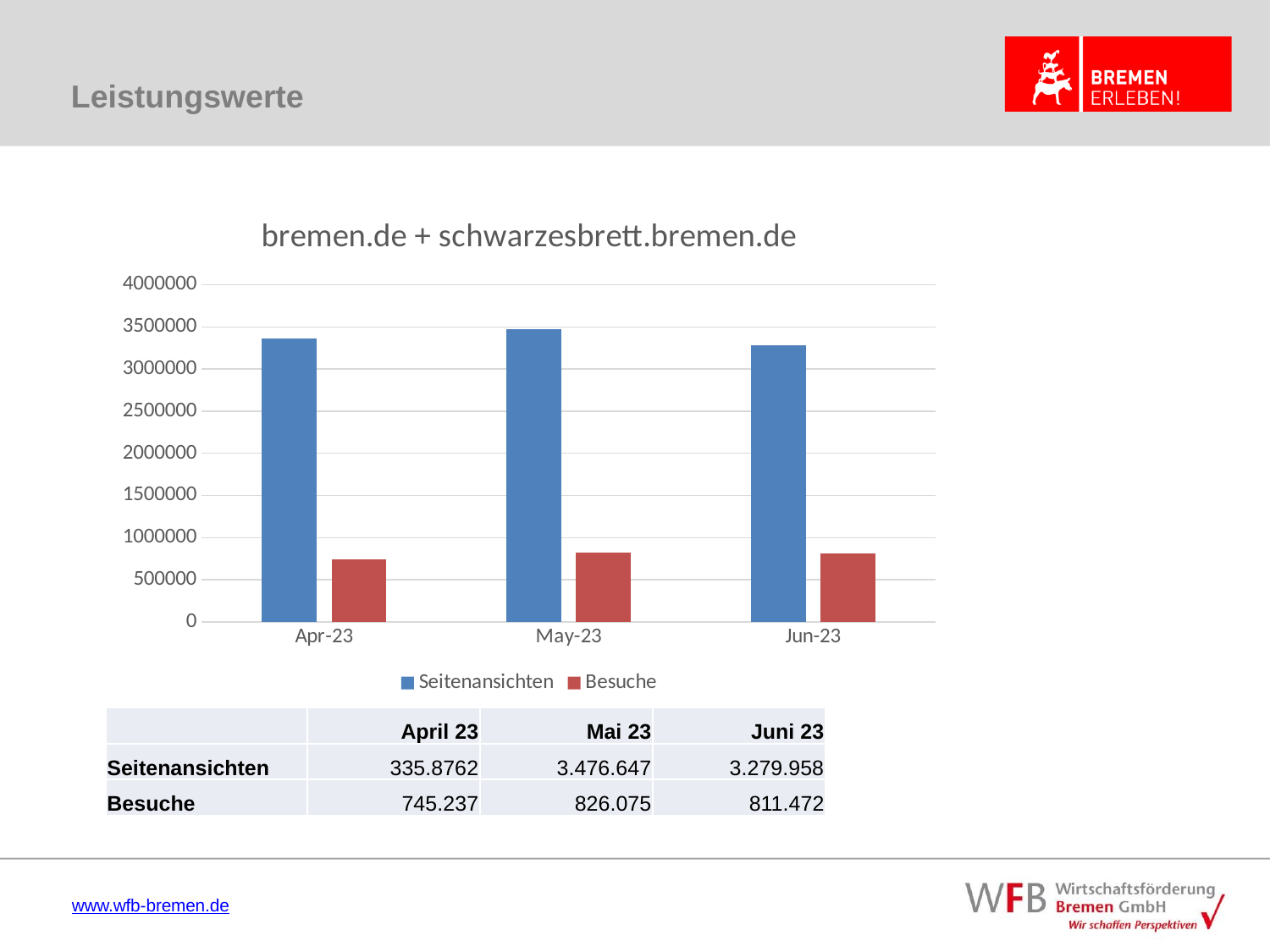
What is the difference between Seitenansichten in Mai 23 and Juni 23? 196.689 Which month has the highest value for Seitenansichten? May-23 Is the value for Seitenansichten in Apr-23 greater or less than 3000000? greater What is the title of the chart? bremen.de + schwarzesbrett.bremen.de Is the value for Besuche in Jun-23 greater or less than 1000000? less Which month has the lowest value for Besuche? Apr-23 Which colour represents Besuche in the chart? red What is the value of Besuche for Juni 23 according to the table? 811.472 What is the value of Seitenansichten for Mai 23 according to the table? 3.476.647 How many series does the chart legend list? 2 What kind of chart is shown on the slide? bar chart How many months are shown on the x axis of the chart? 3